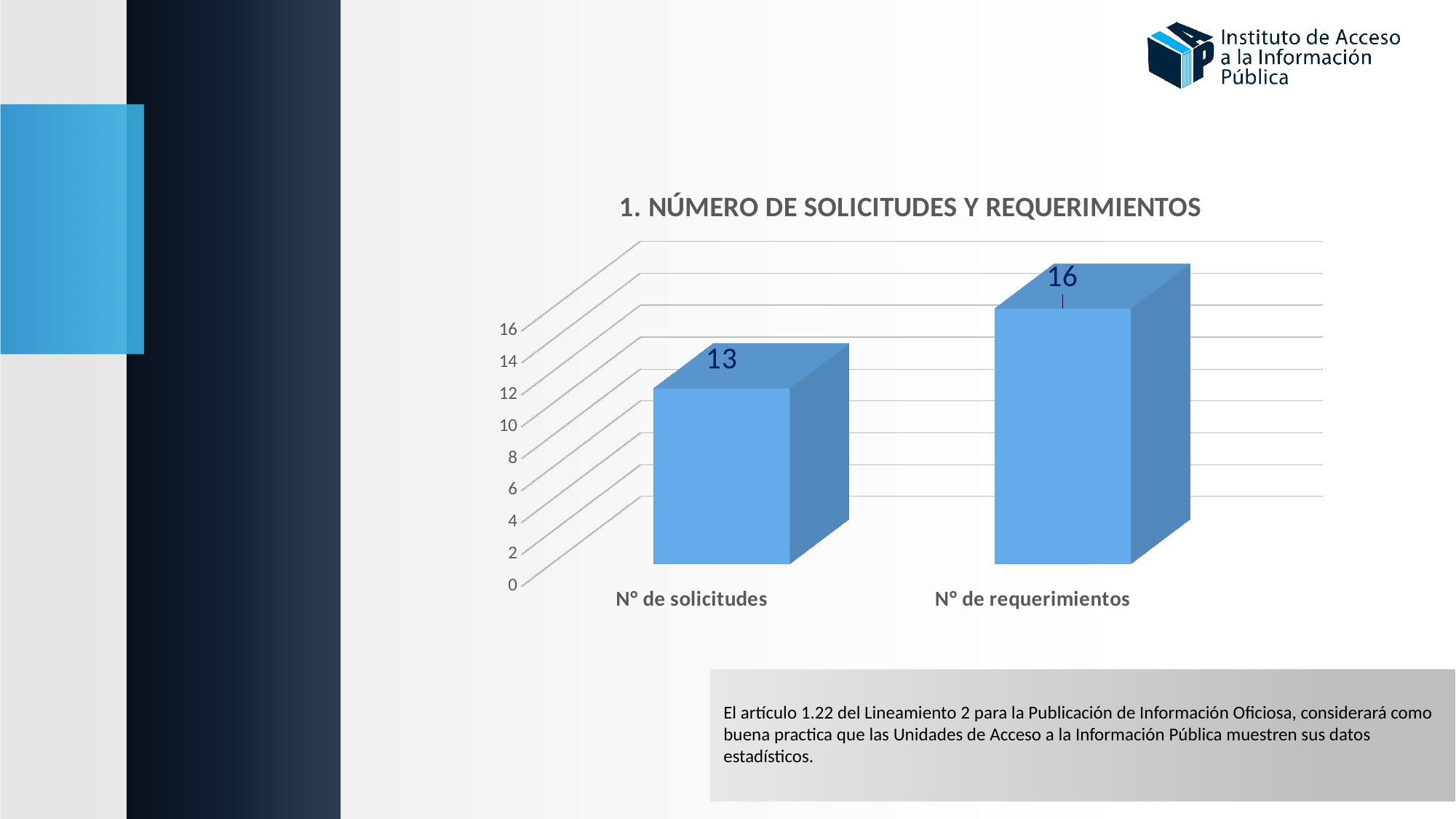
Which category has the lowest value? N° de solicitudes What is the value for N° de solicitudes? 13 What kind of chart is shown on the slide? Bar chart Which is larger, N° de solicitudes or N° de requerimientos? N° de requerimientos What is the title of the chart? 1. NÚMERO DE SOLICITUDES Y REQUERIMIENTOS What is the highest value shown on the vertical axis? 16 What is the value for N° de requerimientos? 16 Which category has the highest value? N° de requerimientos How many categories are shown in the chart? 2 Is the value for N° de solicitudes greater or less than 10? greater What is the difference between N° de requerimientos and N° de solicitudes? 3